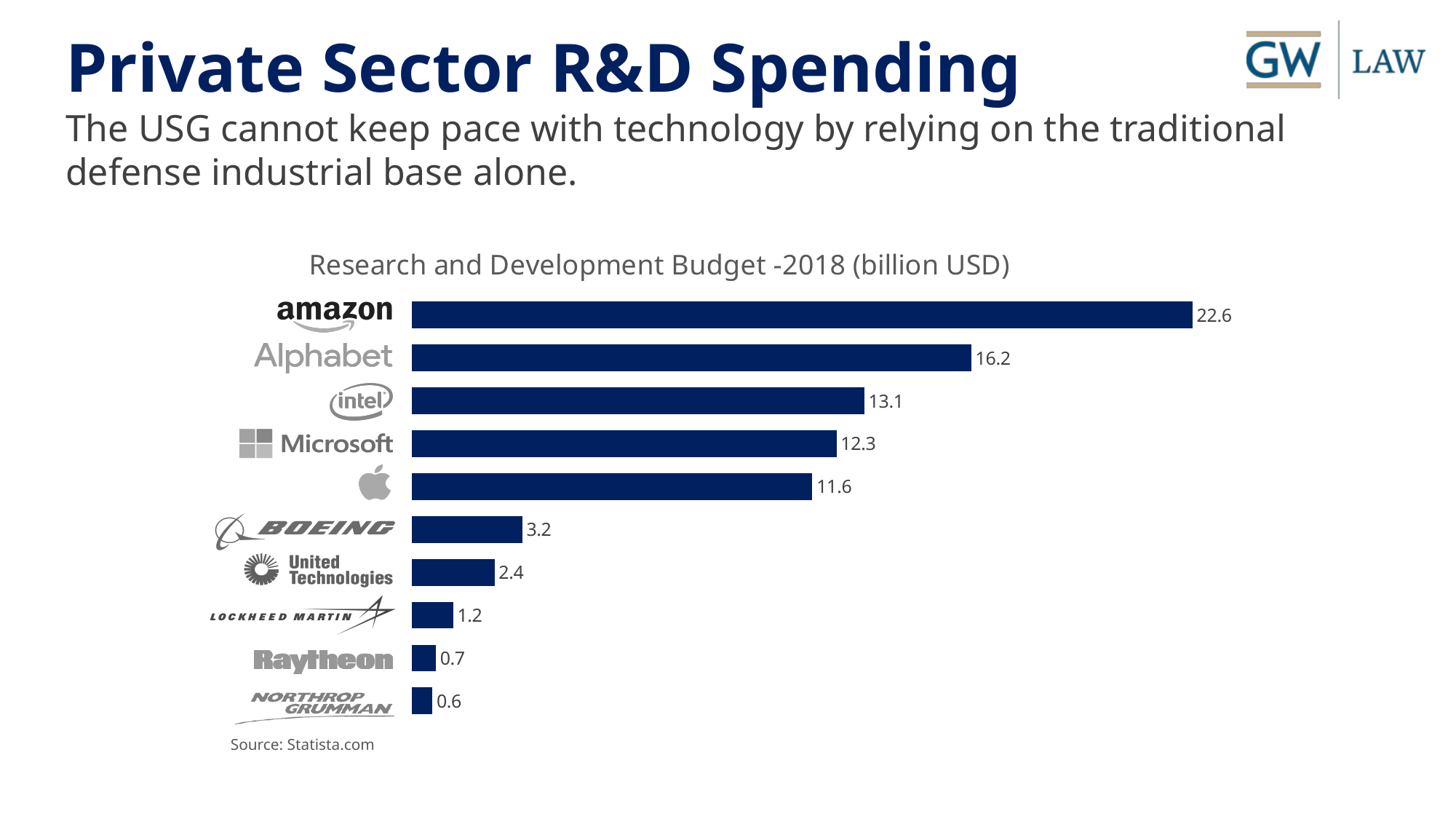
What is the R&D budget value shown for Boeing? 3.2 Which company has the highest R&D budget in the chart? Amazon Which has a larger R&D budget, Boeing or United Technologies? Boeing What is the title of the chart? Research and Development Budget -2018 (billion USD) What is the R&D budget value shown for Amazon? 22.6 Which company has the lowest R&D budget in the chart? Northrop Grumman What kind of chart is shown on the slide? Bar chart What is the R&D budget value shown for Microsoft? 12.3 How many companies are shown in the chart? 10 What is the R&D budget value shown for Lockheed Martin? 1.2 What is the difference between Intel's and Apple's R&D budget values? 1.5 What is the difference between Amazon's and Alphabet's R&D budget values? 6.4